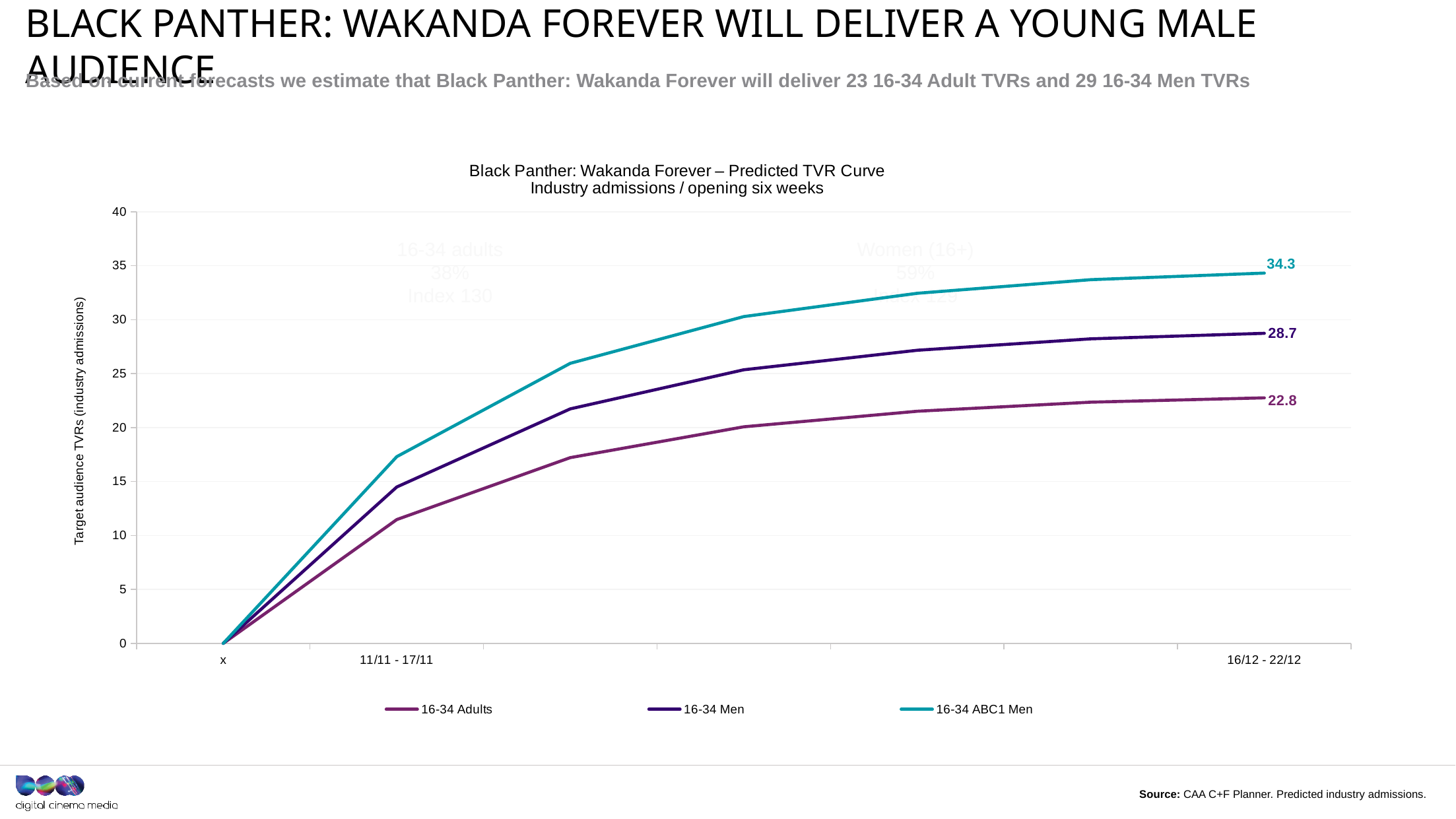
How many series does the legend list? 3 Which series has the lowest value at the end of the period? 16-34 Adults What is the final value shown for 16-34 ABC1 Men at 16/12 - 22/12? 34.3 What is the difference between the final values for 16-34 ABC1 Men and 16-34 Men? 5.6 What kind of chart is shown on the slide? line chart What is the label on the y axis? Target audience TVRs (industry admissions) Do the lines rise or fall along the x axis? rise What is the difference between the final values for 16-34 ABC1 Men and 16-34 Adults? 11.5 What is the final value shown for 16-34 Men at 16/12 - 22/12? 28.7 Which series reaches the highest value at the end of the period? 16-34 ABC1 Men Is the value for 16-34 Adults at 11/11 - 17/11 greater or less than 15? less What is the final value shown for 16-34 Adults at 16/12 - 22/12? 22.8